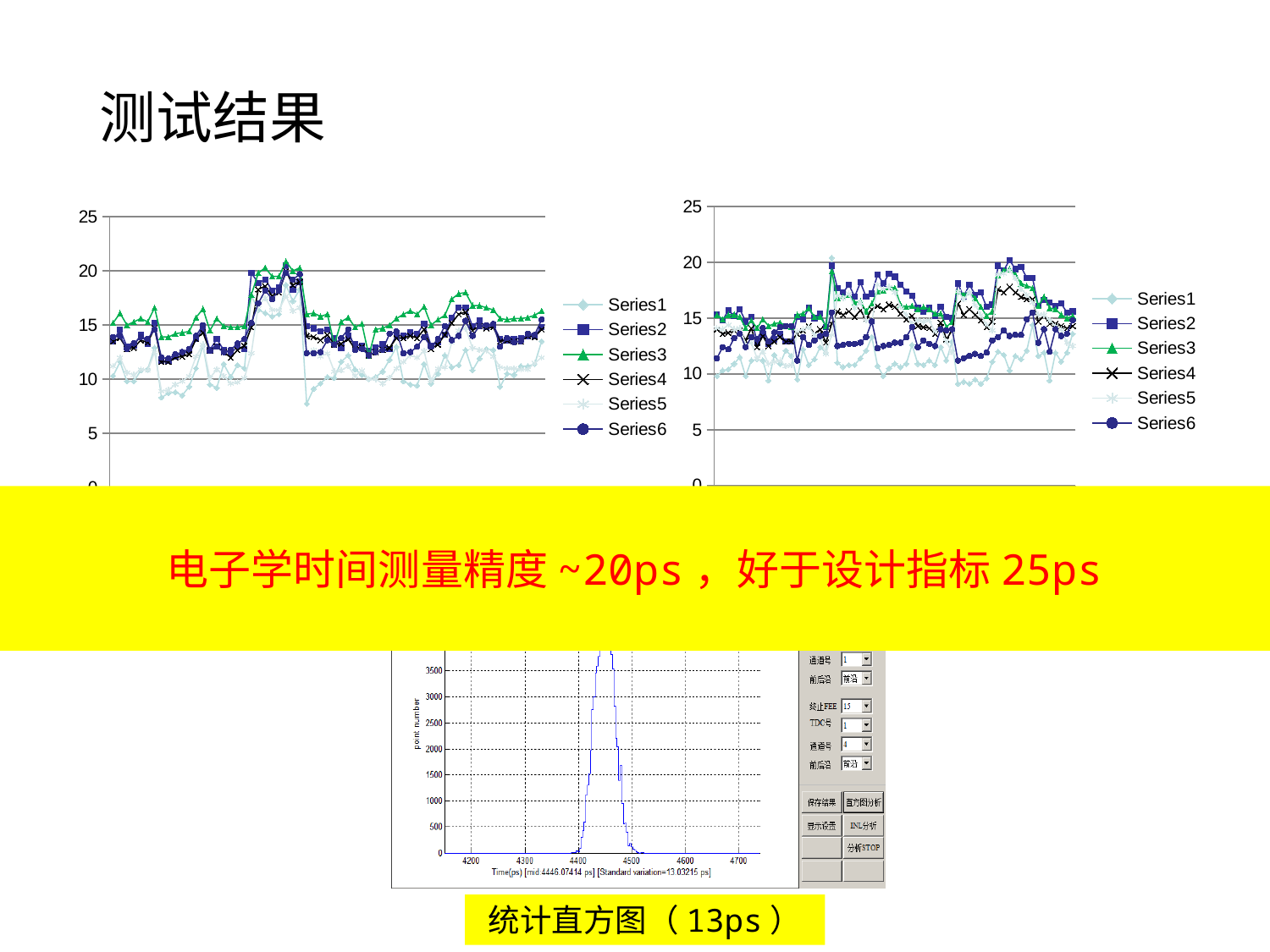
In the histogram at the bottom of the slide, is the peak of the distribution greater or less than 3000? greater What is the label of the x axis of the histogram at the bottom of the slide? Time(ps) What is the highest value shown on the y axis of the left chart? 25 In the left chart, is the lowest value of Series1 greater or less than 10? less How many series does the legend of the right chart list? 6 In the left chart, which series is drawn with green triangle markers? Series3 How many series does the legend of the left chart list? 6 What kind of chart is the chart on the left of the slide? line chart In the left chart, is the peak value of Series3 greater or less than 20? greater